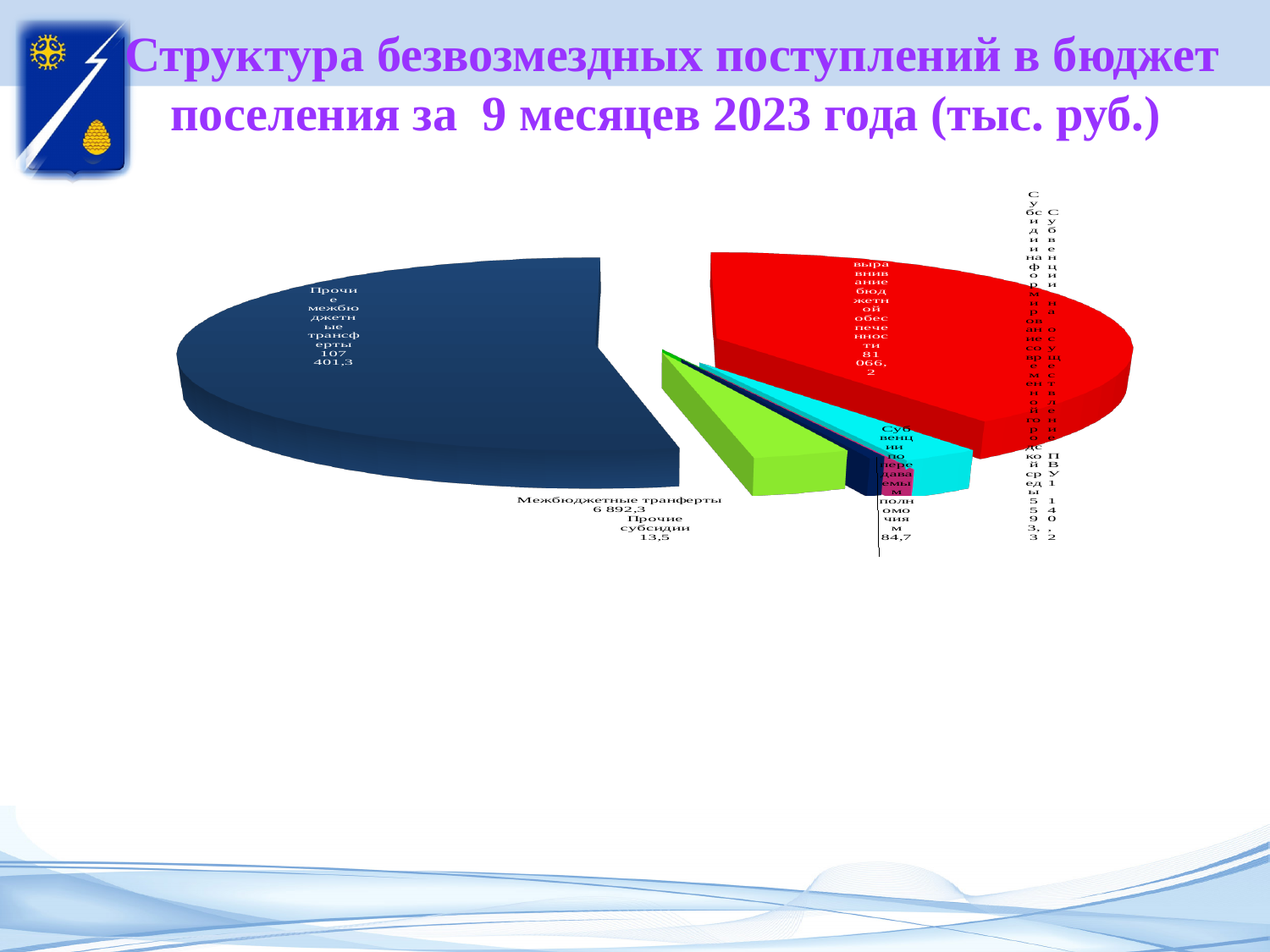
What is the value for the slice labelled выравнивание бюджетной обеспеченности? 81 066,2 Which category has the smallest value shown on the chart? Прочие субсидии What is the value for Прочие субсидии? 13,5 Which is larger: Прочие межбюджетные трансферты or выравнивание бюджетной обеспеченности? Прочие межбюджетные трансферты What kind of chart is shown on the slide? Pie chart What is the value for Межбюджетные трансферты? 6 892,3 Which category has the largest slice of the pie? Прочие межбюджетные трансферты In what units are the values on the chart given, according to the slide title? тыс. руб. What is the value for Субвенции по передаваемым полномочиям? 84,7 What is the difference between Межбюджетные трансферты (6 892,3) and Субвенции по передаваемым полномочиям (84,7)? 6 807,6 What is the difference between Прочие межбюджетные трансферты (107 401,3) and выравнивание бюджетной обеспеченности (81 066,2)? 26 335,1 What is the value for Прочие межбюджетные трансферты? 107 401,3